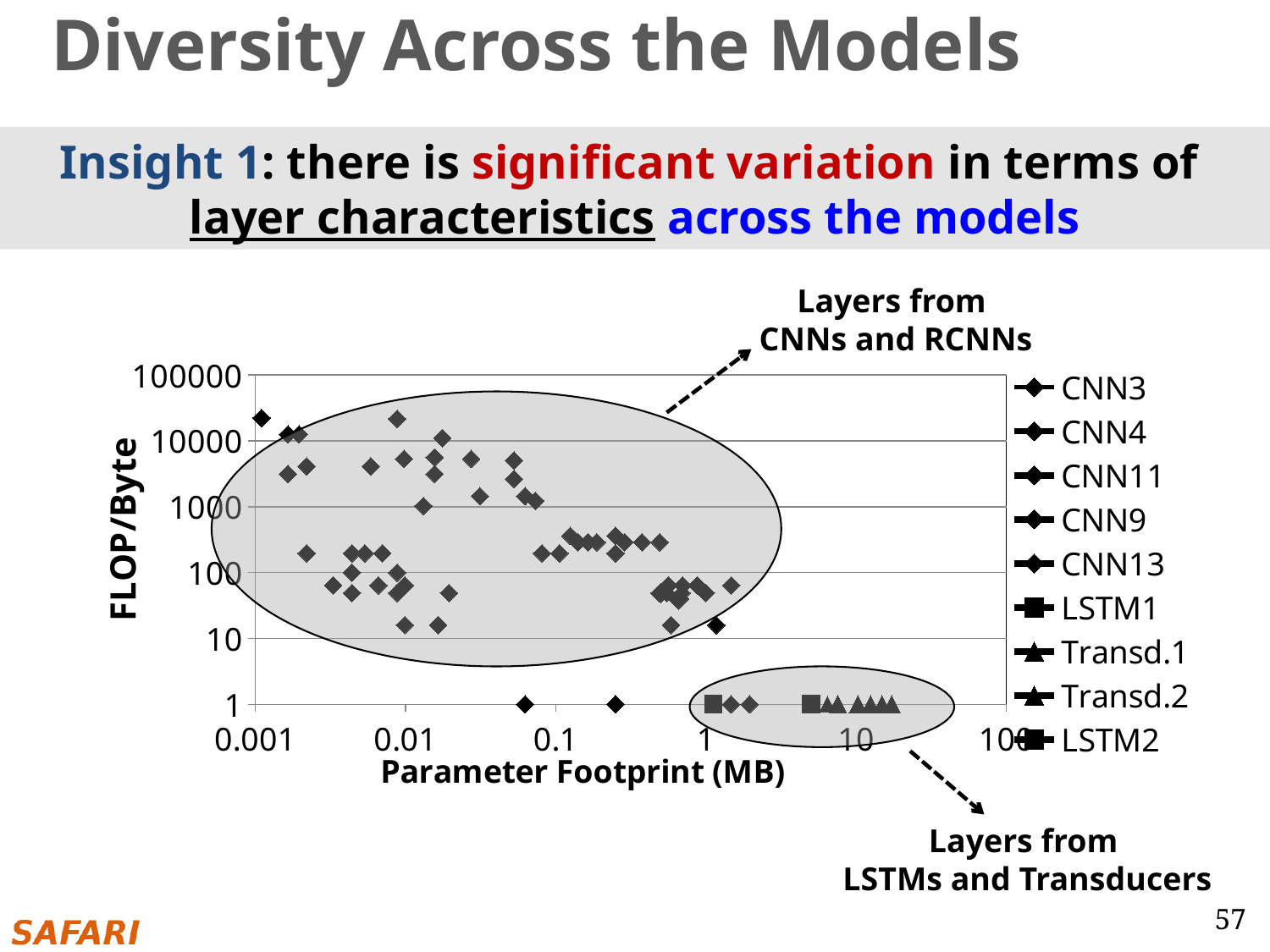
Which series is listed first in the legend? CNN3 What is the highest value shown on the y axis? 100000 What kind of chart is shown on the slide? scatter chart Are the parameter footprints of the layers from LSTMs and Transducers greater or less than 1 MB? greater Which group of layers has the larger parameter footprint: the layers from CNNs and RCNNs or the layers from LSTMs and Transducers? Layers from LSTMs and Transducers What is the smallest value shown on the x axis? 0.001 Are the FLOP/Byte values of the layers from LSTMs and Transducers greater or less than 10? less How many series does the legend list? 9 Which group of layers has higher FLOP/Byte values: the layers from CNNs and RCNNs or the layers from LSTMs and Transducers? Layers from CNNs and RCNNs